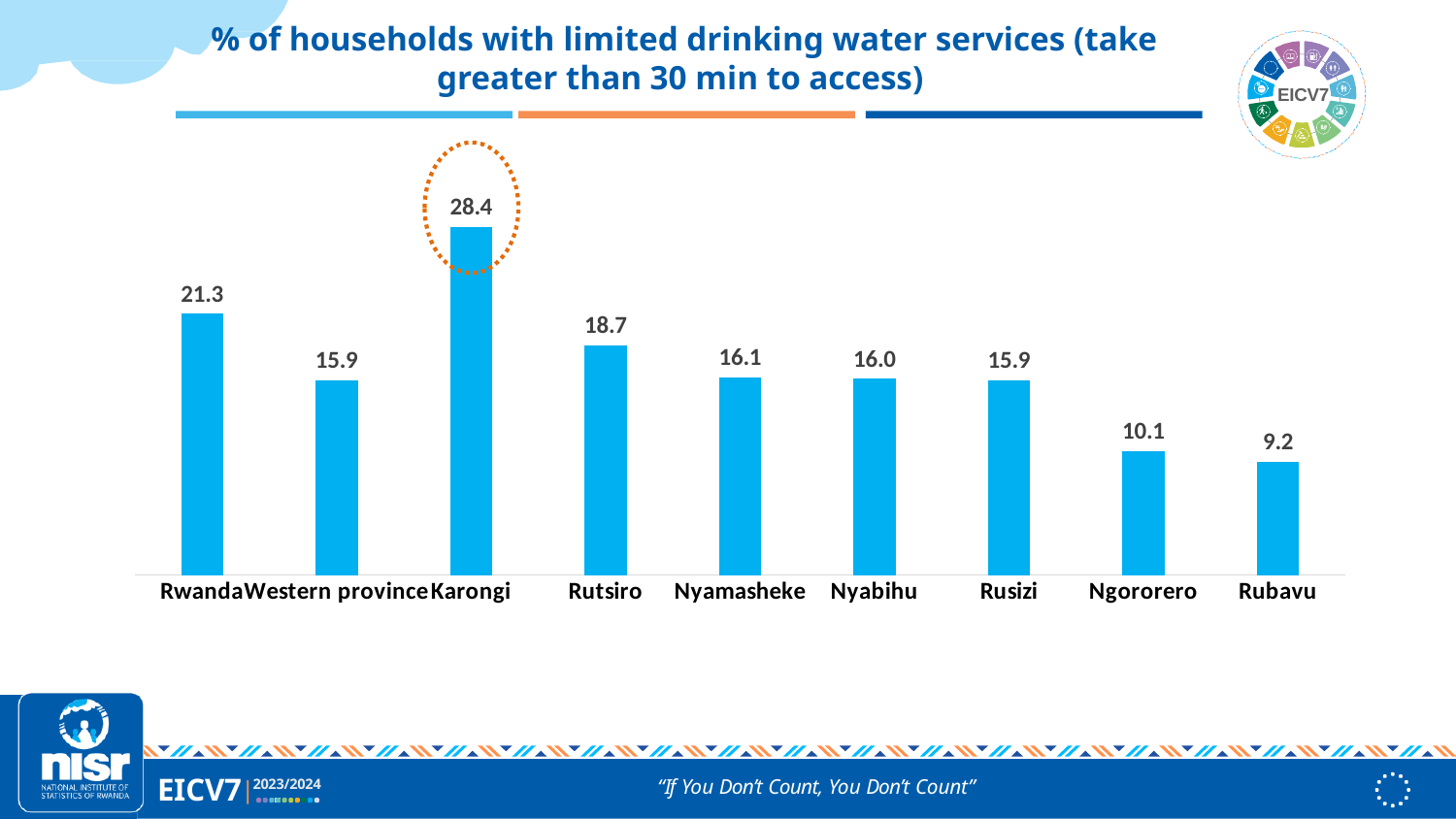
Which category has the lowest value? Rubavu What is the difference between the values for Rwanda and Rutsiro? 2.6 What kind of chart is shown on the slide? Bar chart Which category's bar is highlighted with a dotted orange circle? Karongi What is the difference between the values for Karongi and Rubavu? 19.2 What is the value for Western province? 15.9 How many categories are shown on the x axis? 9 What is the value for Karongi? 28.4 What is the value for Ngororero? 10.1 Which category has the highest value? Karongi Which is larger, the value for Rutsiro or the value for Nyamasheke? Rutsiro What is the value for Rwanda? 21.3